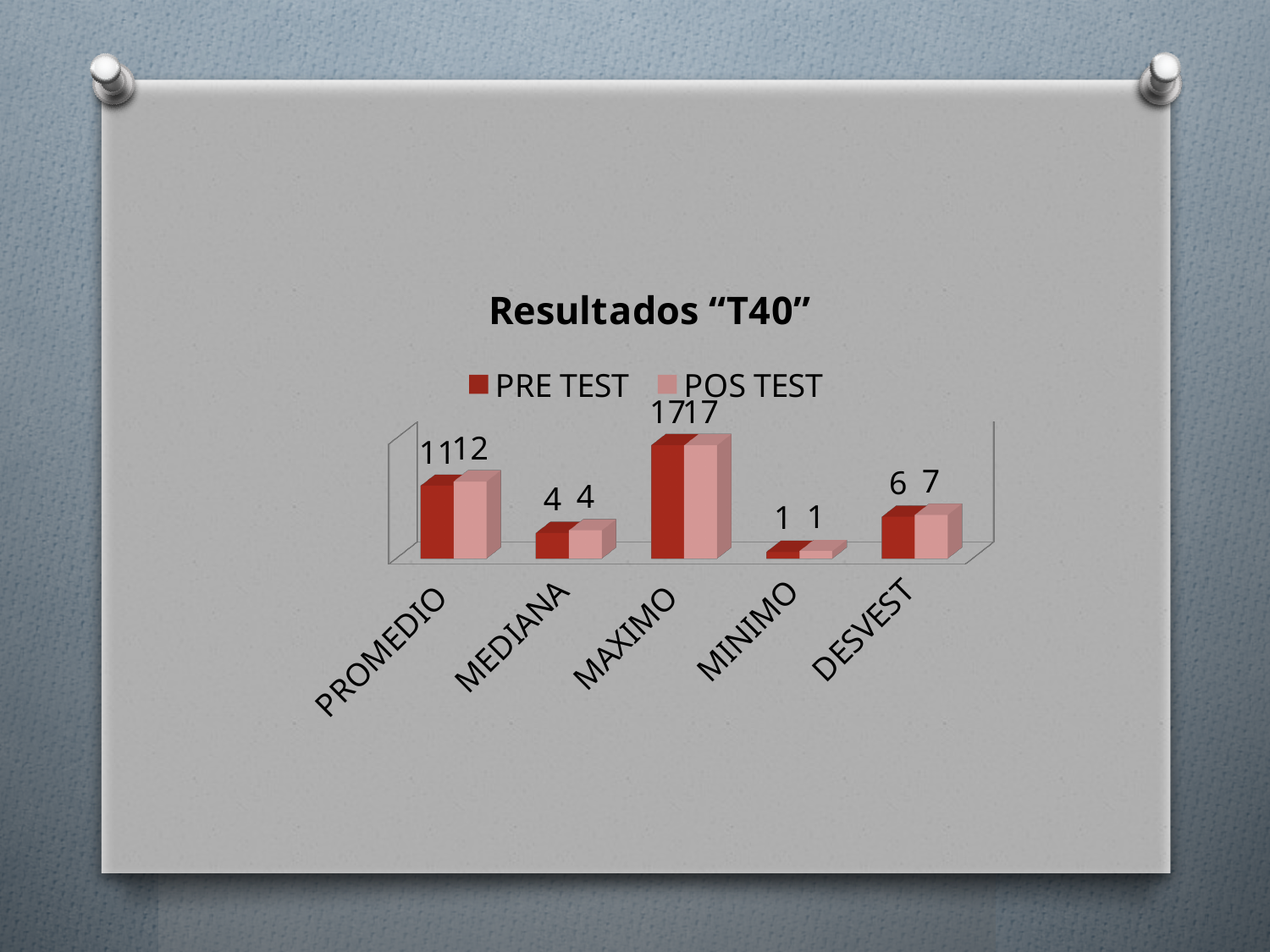
How many series does the legend list? 2 What is the PRE TEST value for MAXIMO? 17 What is the POS TEST value for PROMEDIO? 12 What kind of chart is shown on the slide? Bar chart What is the POS TEST value for DESVEST? 7 Which category has the highest PRE TEST value? MAXIMO What is the PRE TEST value for MEDIANA? 4 How many categories are shown on the x axis? 5 Which is larger, the PRE TEST value for DESVEST or the PRE TEST value for MEDIANA? DESVEST What is the difference between the POS TEST and PRE TEST values for PROMEDIO? 1 What is the PRE TEST value for PROMEDIO? 11 Which category has the lowest POS TEST value? MINIMO